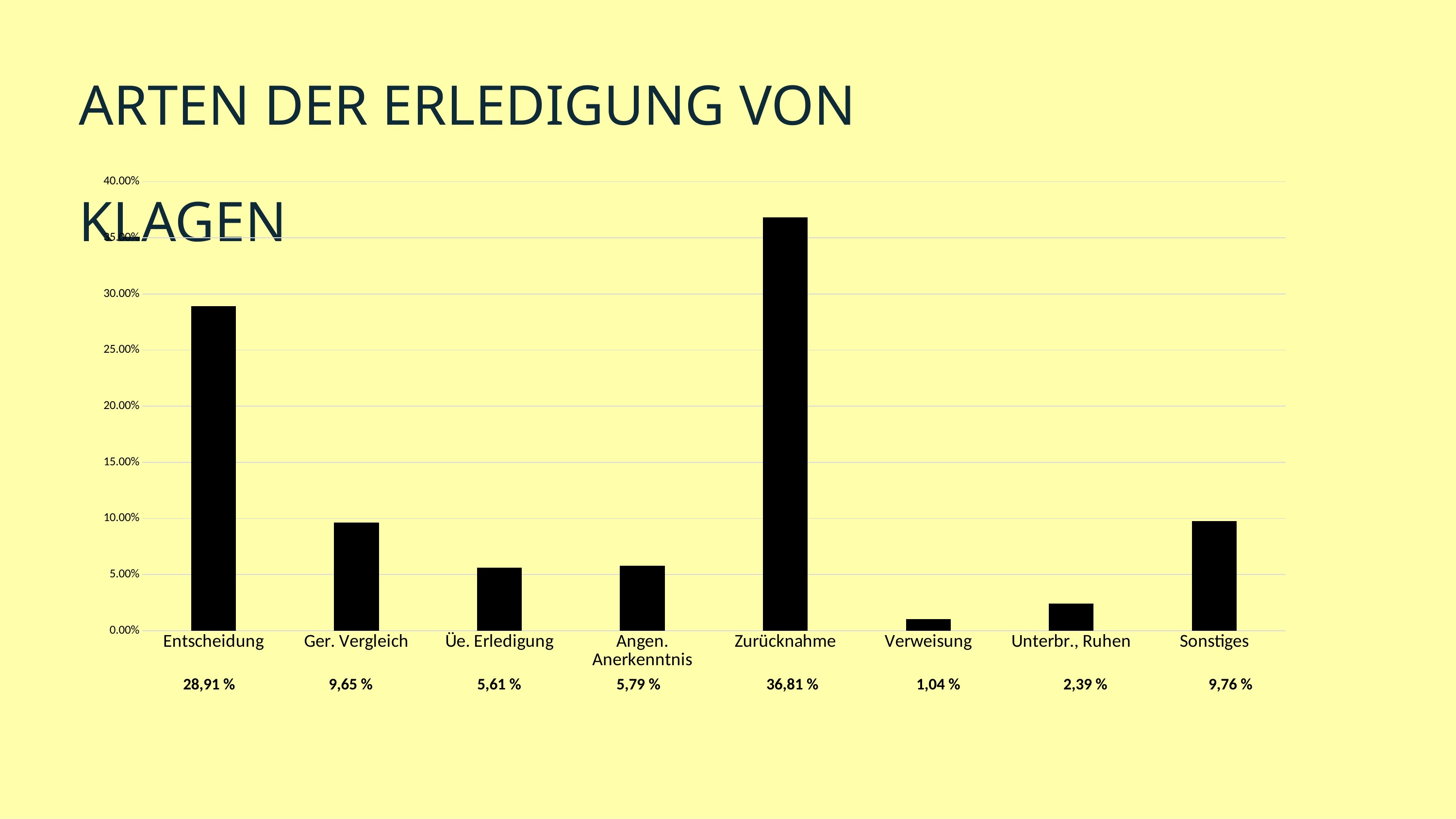
Is the value for Entscheidung greater or less than 25.00%? greater What is the value for Unterbr., Ruhen? 2,39 % What is the value for Entscheidung? 28,91 % Which category has the lowest value? Verweisung What is the title of the slide? ARTEN DER ERLEDIGUNG VON KLAGEN What type of chart is shown on the slide? bar chart What is the value for Zurücknahme? 36,81 % What is the difference between the values for Zurücknahme and Entscheidung? 7,90 % How many categories are shown in the chart? 8 Which category has the highest value? Zurücknahme Which is larger, the value for Ger. Vergleich or the value for Üe. Erledigung? Ger. Vergleich What is the value for Verweisung? 1,04 %